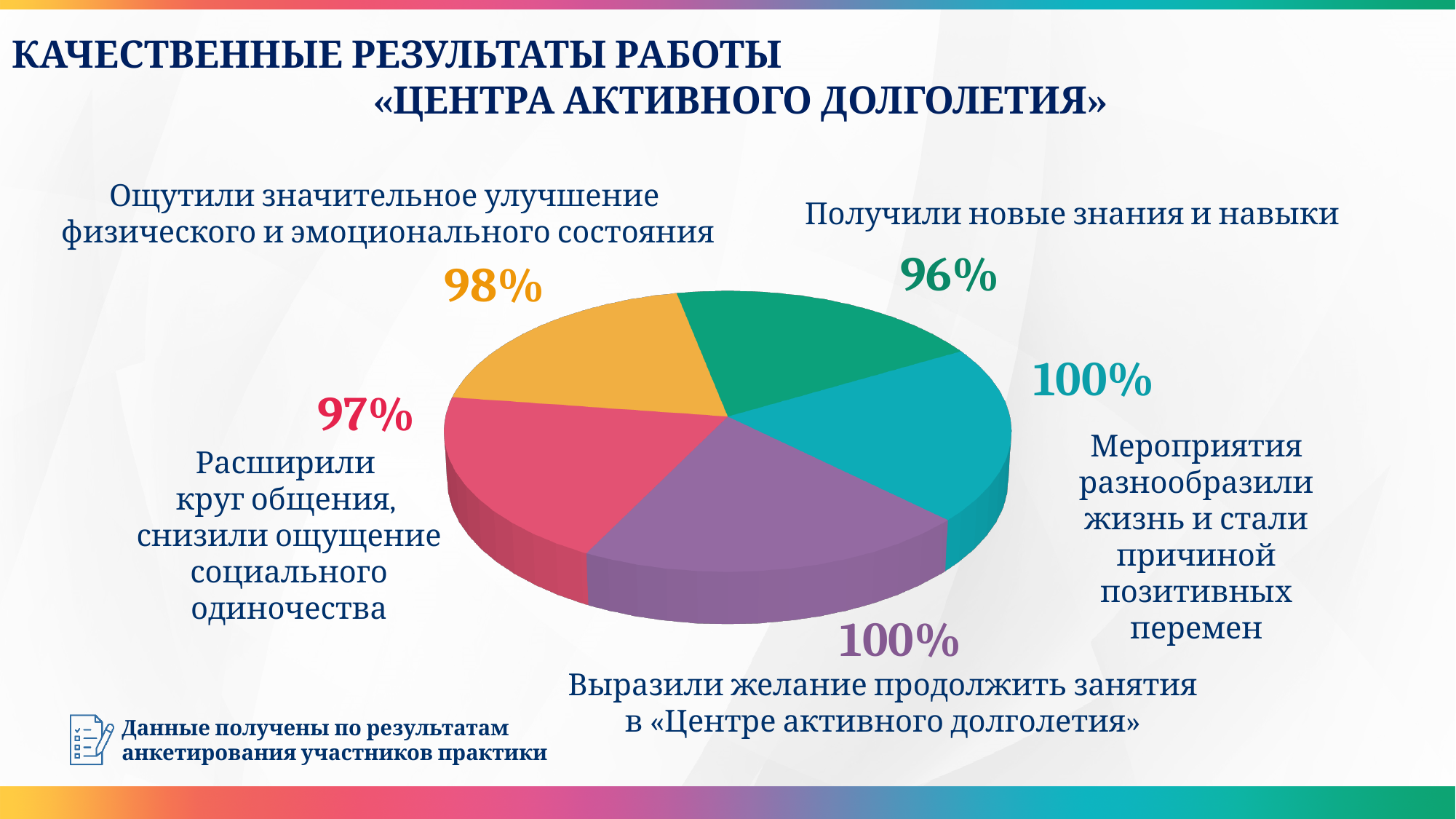
Сколько категорий имеют значение 100%? 2 Какая категория имеет наименьшее значение? Получили новые знания и навыки Каким цветом показан сектор со значением 98%? Оранжевым (жёлтым) Какое значение указано для категории «Мероприятия разнообразили жизнь и стали причиной позитивных перемен»? 100% Какое значение указано для категории «Выразили желание продолжить занятия в «Центре активного долголетия»»? 100% Что больше: значение «Ощутили значительное улучшение физического и эмоционального состояния» или «Расширили круг общения, снизили ощущение социального одиночества»? Ощутили значительное улучшение физического и эмоционального состояния Сколько секторов (категорий) на круговой диаграмме? 5 Какое значение указано для категории «Расширили круг общения, снизили ощущение социального одиночества»? 97% Какое значение указано для категории «Получили новые знания и навыки»? 96% На сколько процентных пунктов значение «Ощутили значительное улучшение физического и эмоционального состояния» больше значения «Получили новые знания и навыки»? 2 Какое значение указано для категории «Ощутили значительное улучшение физического и эмоционального состояния»? 98% Какой тип диаграммы показан на слайде? Круговая диаграмма